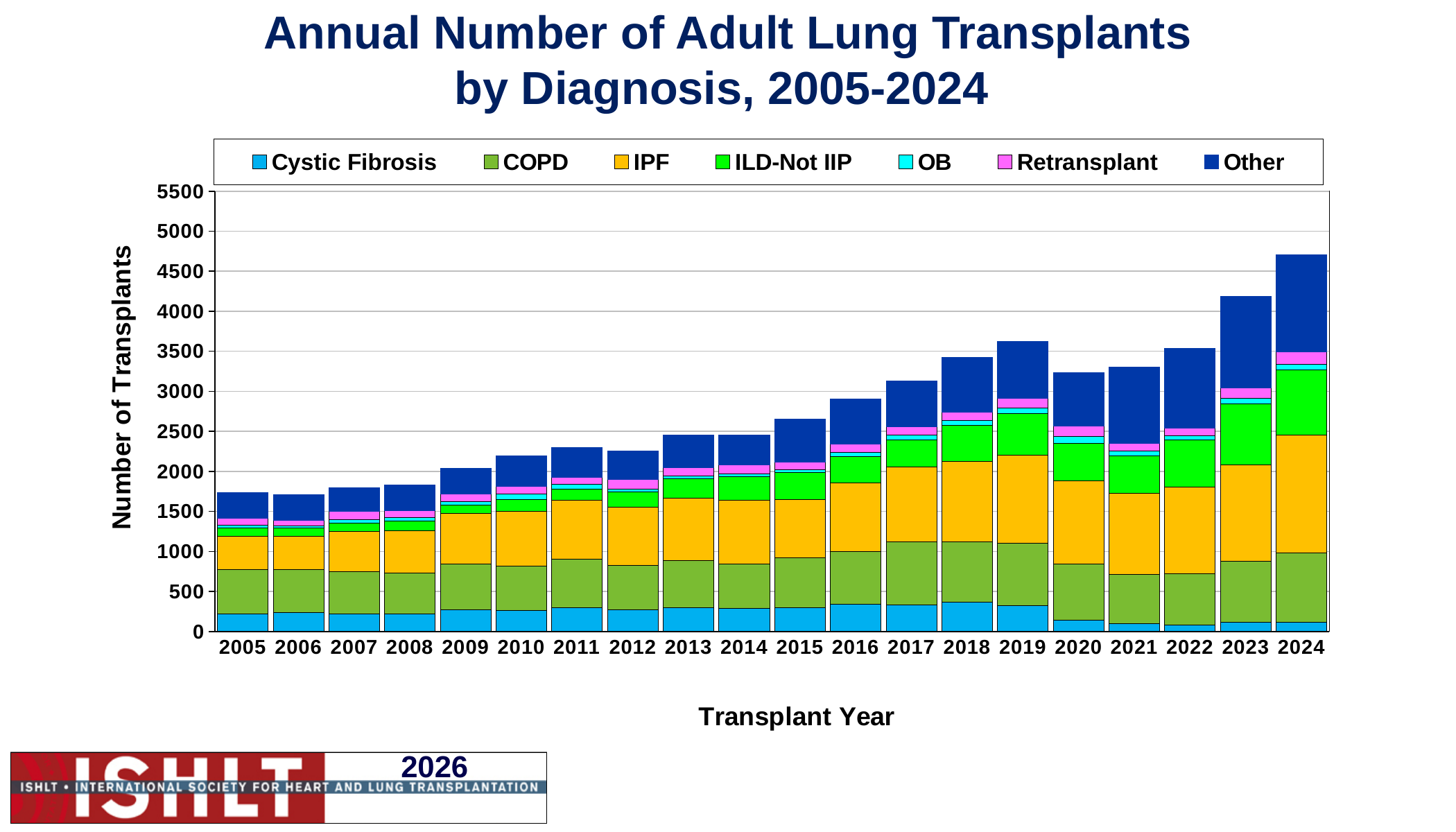
Is the total number of transplants in 2020 greater or less than 3500? less What kind of chart is shown on the slide? Stacked bar chart How many transplant years are shown on the x axis? 20 Is the total number of transplants in 2023 greater or less than 4000? greater Which year has a larger total number of transplants, 2019 or 2020? 2019 What is the title of the chart? Annual Number of Adult Lung Transplants by Diagnosis, 2005-2024 What is the label of the y axis? Number of Transplants Which transplant year has the highest total number of adult lung transplants? 2024 Overall, does the total number of adult lung transplants rise or fall from 2005 to 2024? Rise How many diagnosis series does the legend list? 7 Is the total number of transplants in 2005 greater or less than 2000? less